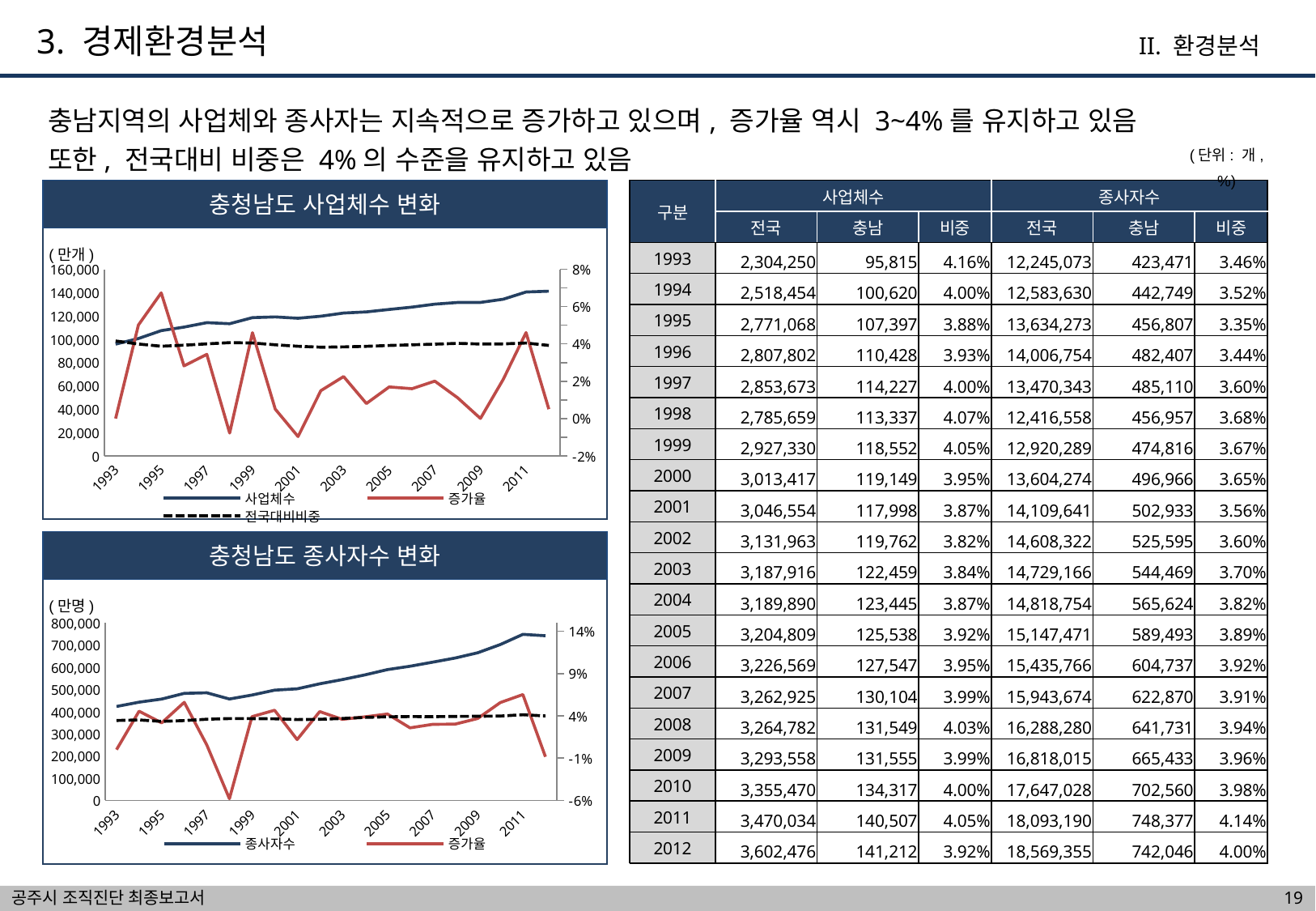
In the top chart (충청남도 사업체수 변화), is the 사업체수 value for 1993 greater or less than 80,000? greater In the top chart (충청남도 사업체수 변화), is the 사업체수 value for 2012 greater or less than 120,000? greater In the top chart (충청남도 사업체수 변화), does the 사업체수 line generally rise or fall from 1993 to 2012? rise In the top chart (충청남도 사업체수 변화), which year has the lowest 사업체수 value? 1993 What kind of chart is the bottom chart titled 충청남도 종사자수 변화? line chart In the bottom chart (충청남도 종사자수 변화), is the 종사자수 value for 2012 greater or less than 700,000? greater In the top chart (충청남도 사업체수 변화), which series is drawn as a dashed line? 전국대비비중 In the top chart (충청남도 사업체수 변화), how many series does the legend list? 3 In the bottom chart (충청남도 종사자수 변화), how many series does the legend list? 2 In the bottom chart (충청남도 종사자수 변화), does the 종사자수 line generally rise or fall from 1993 to 2012? rise What kind of chart is the top chart titled 충청남도 사업체수 변화? line chart